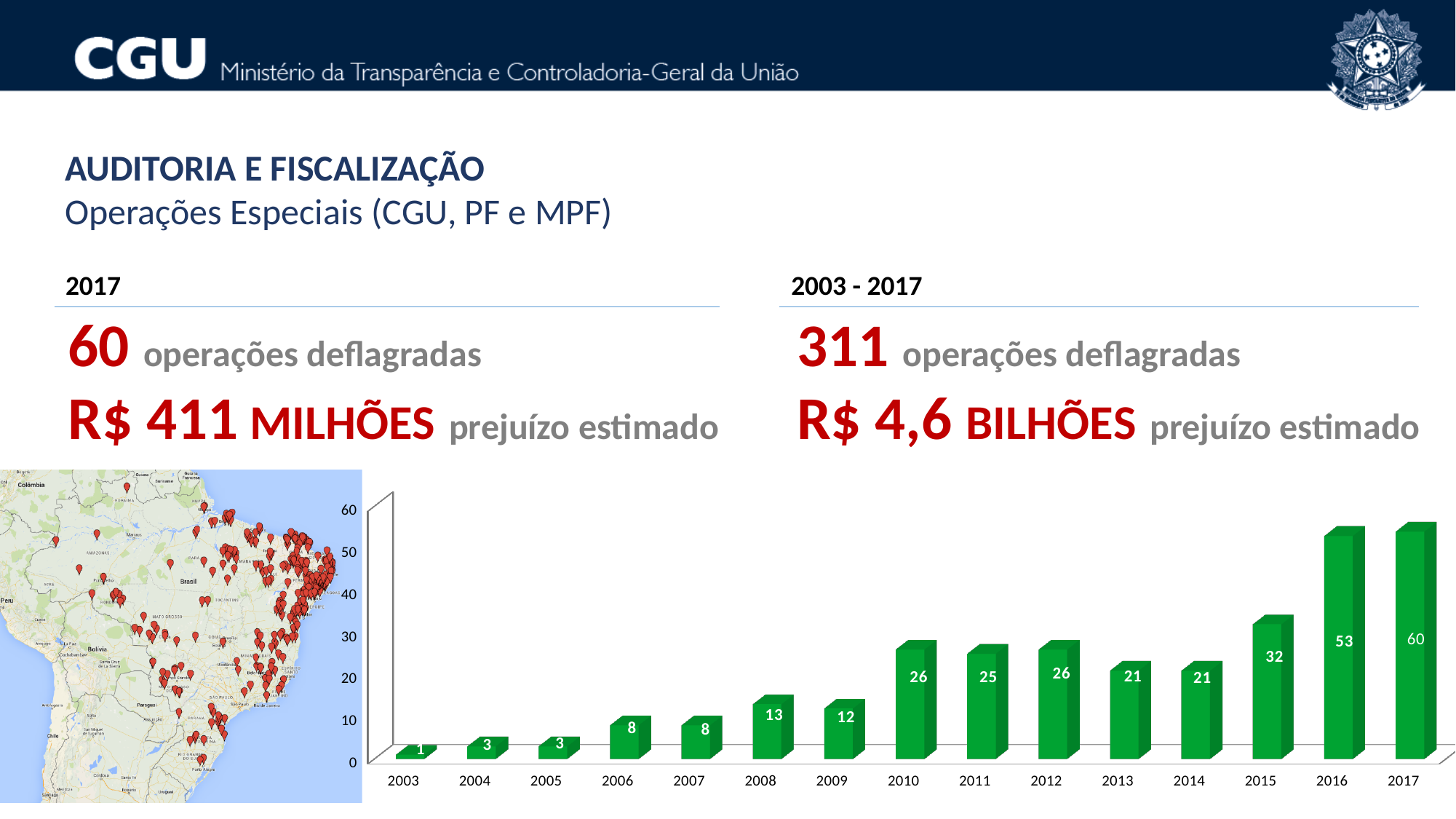
What is the difference between the values for 2015 and 2014 in the bar chart? 11 What is the difference between the values for 2017 and 2016 in the bar chart? 7 Which is larger in the bar chart, the value for 2008 or the value for 2009? 2008 What is the value for 2010 in the bar chart? 26 Which year has the lowest value in the bar chart? 2003 What kind of chart is shown on the slide? bar chart What is the value for 2015 in the bar chart? 32 Is the value for 2016 in the bar chart greater or less than 50? greater Which year has the highest value in the bar chart? 2017 What is the value for 2003 in the bar chart? 1 Do the values in the bar chart generally rise or fall from 2003 to 2017? rise How many years are shown on the x axis of the bar chart? 15